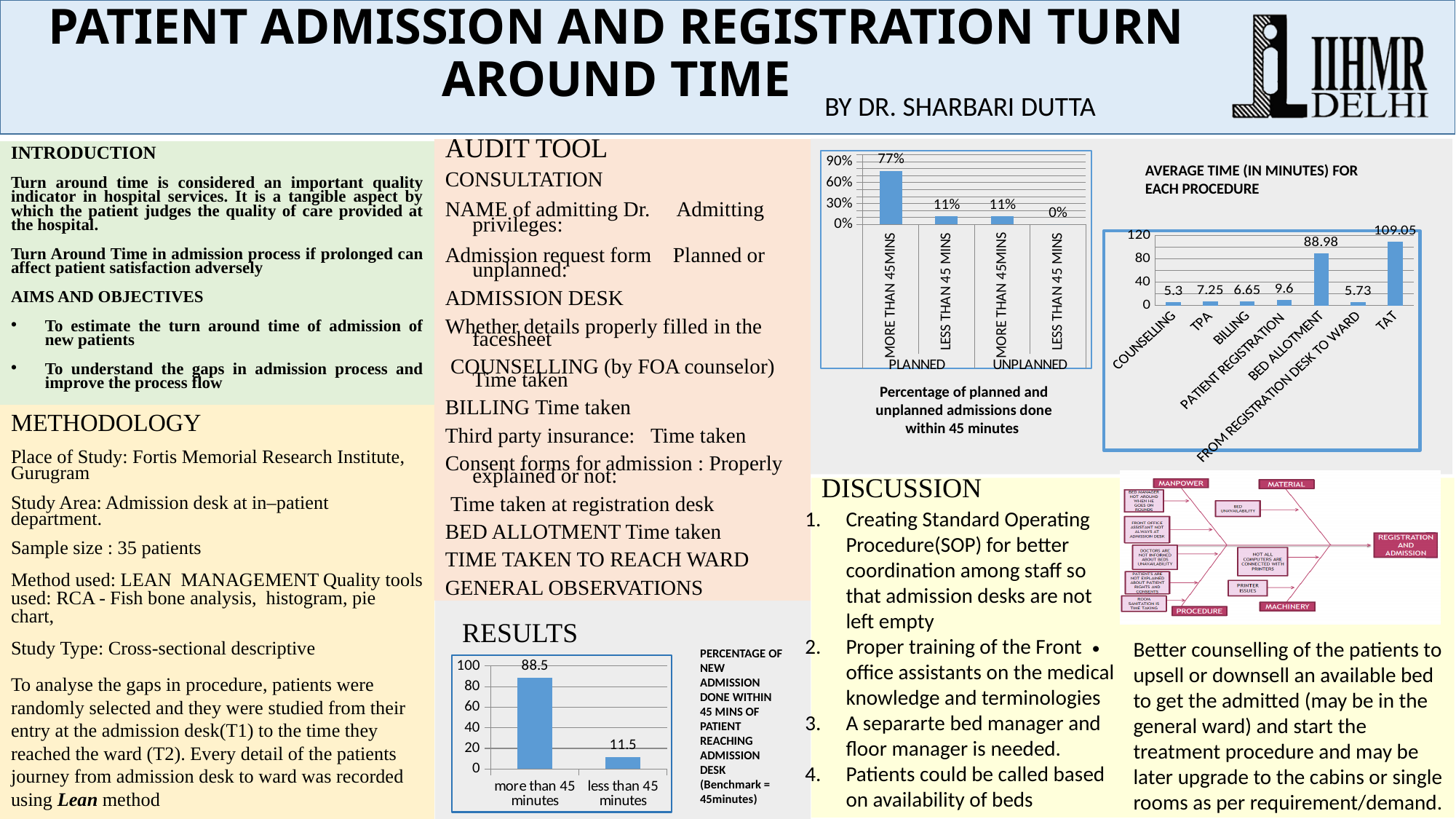
In the 'AVERAGE TIME (IN MINUTES) FOR EACH PROCEDURE' chart, which is larger, TPA or BILLING? TPA In the 'Percentage of planned and unplanned admissions done within 45 minutes' chart, how many bars are plotted? 4 In the RESULTS chart at the bottom of the slide, what is the value for 'less than 45 minutes'? 11.5 In the 'AVERAGE TIME (IN MINUTES) FOR EACH PROCEDURE' chart, what is the difference between PATIENT REGISTRATION and COUNSELLING? 4.3 In the 'AVERAGE TIME (IN MINUTES) FOR EACH PROCEDURE' chart, how many procedures are shown on the x axis? 7 In the RESULTS chart at the bottom of the slide, what is the difference between 'more than 45 minutes' and 'less than 45 minutes'? 77 In the 'Percentage of planned and unplanned admissions done within 45 minutes' chart, what is the value for UNPLANNED LESS THAN 45 MINS? 0% In the 'AVERAGE TIME (IN MINUTES) FOR EACH PROCEDURE' chart, which procedure has the lowest average time? COUNSELLING What type of chart is the RESULTS chart at the bottom of the slide? Bar chart In the 'AVERAGE TIME (IN MINUTES) FOR EACH PROCEDURE' chart, what is the value for BED ALLOTMENT? 88.98 In the 'Percentage of planned and unplanned admissions done within 45 minutes' chart, what is the value for PLANNED MORE THAN 45MINS? 77% In the 'AVERAGE TIME (IN MINUTES) FOR EACH PROCEDURE' chart, what is the value for TAT? 109.05